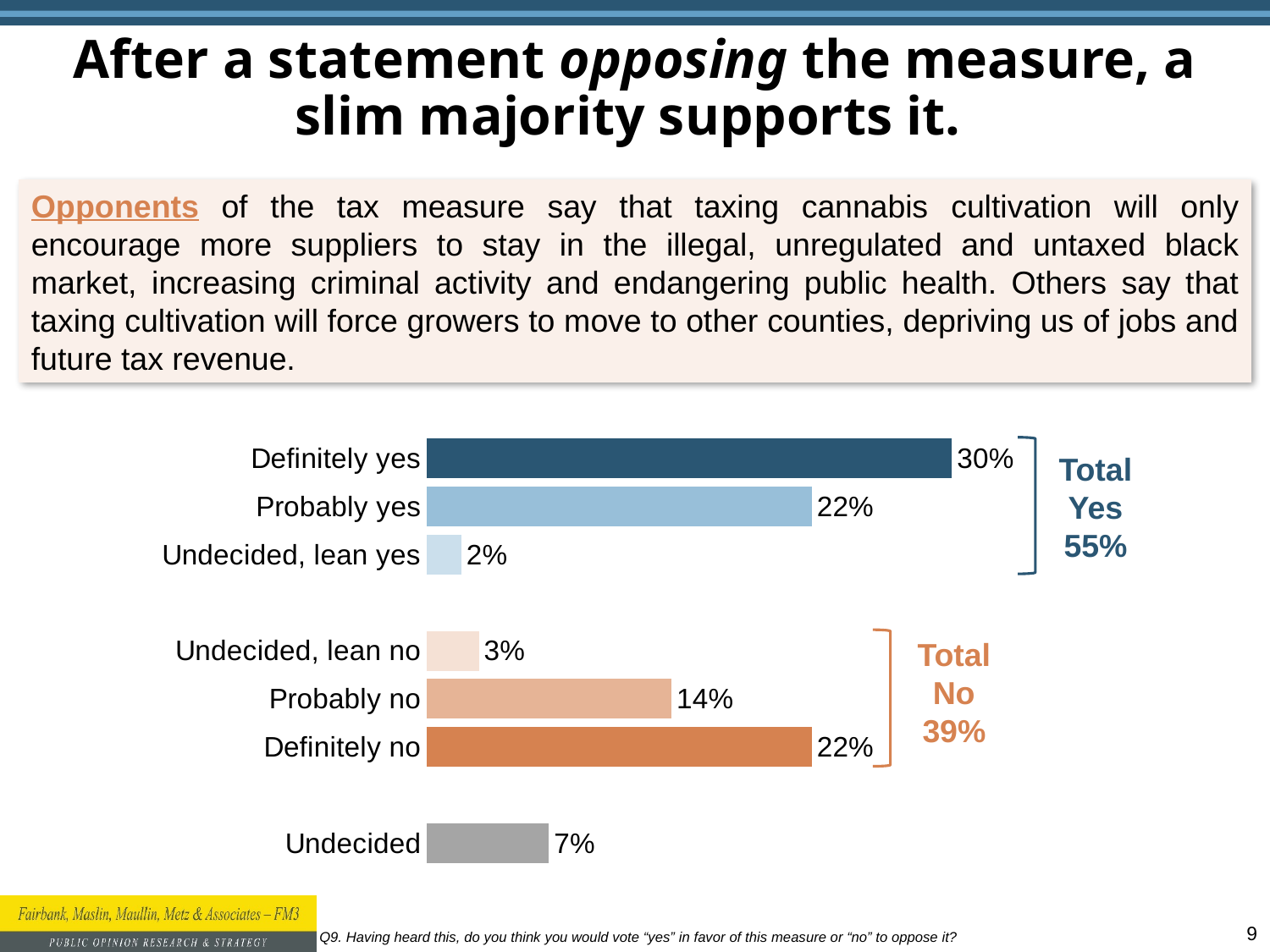
How many categories are shown in the chart? 7 What is the Total No percentage shown on the chart? 39% Which is larger, "Probably no" or "Undecided"? Probably no What is the difference between "Definitely yes" and "Definitely no"? 8% Which category has the highest value? Definitely yes What is the value for "Undecided, lean no"? 3% What is the value for "Definitely yes"? 30% What kind of chart is shown on the slide? Bar chart What is the Total Yes percentage shown on the chart? 55% Which category has the lowest value? Undecided, lean yes What is the value for "Undecided"? 7% What is the value for "Probably no"? 14%